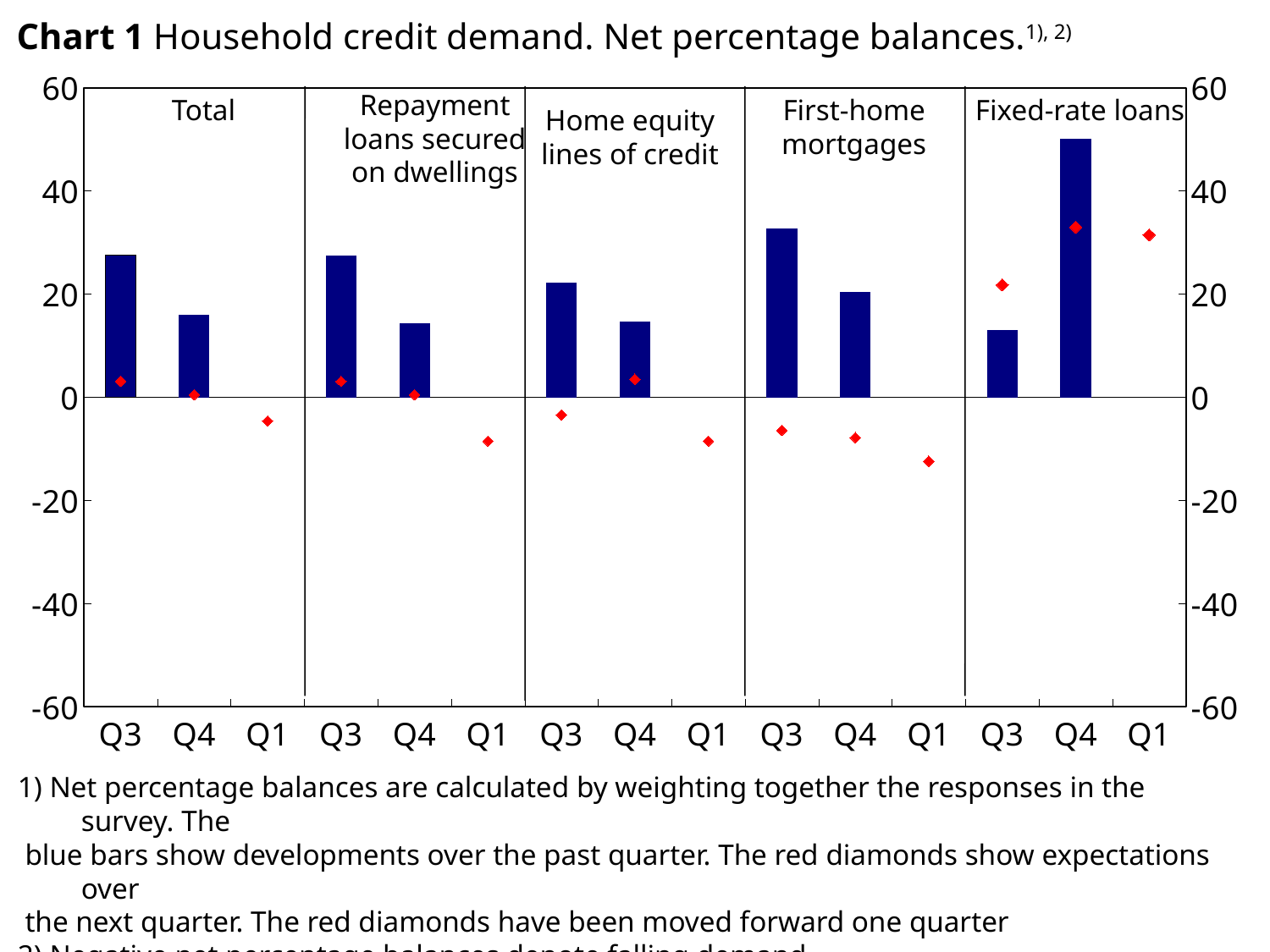
Which panel has the lowest Q1 red diamond? First-home mortgages In the Fixed-rate loans panel, which bar is larger, Q3 or Q4? Q4 Is the Q4 bar for Fixed-rate loans greater or less than 40? greater Is the Q1 red diamond for Fixed-rate loans greater or less than 20? greater In the Total panel, which bar is larger, Q3 or Q4? Q3 According to the footnote, what do the red diamonds show? Expectations over the next quarter Do the bars in the Total panel rise or fall from Q3 to Q4? fall What kind of chart is Chart 1? bar chart Which bar is the highest in Chart 1? Fixed-rate loans Q4 How many credit categories (panels) are shown in Chart 1? 5 Is the Q3 bar for First-home mortgages greater or less than 30? greater